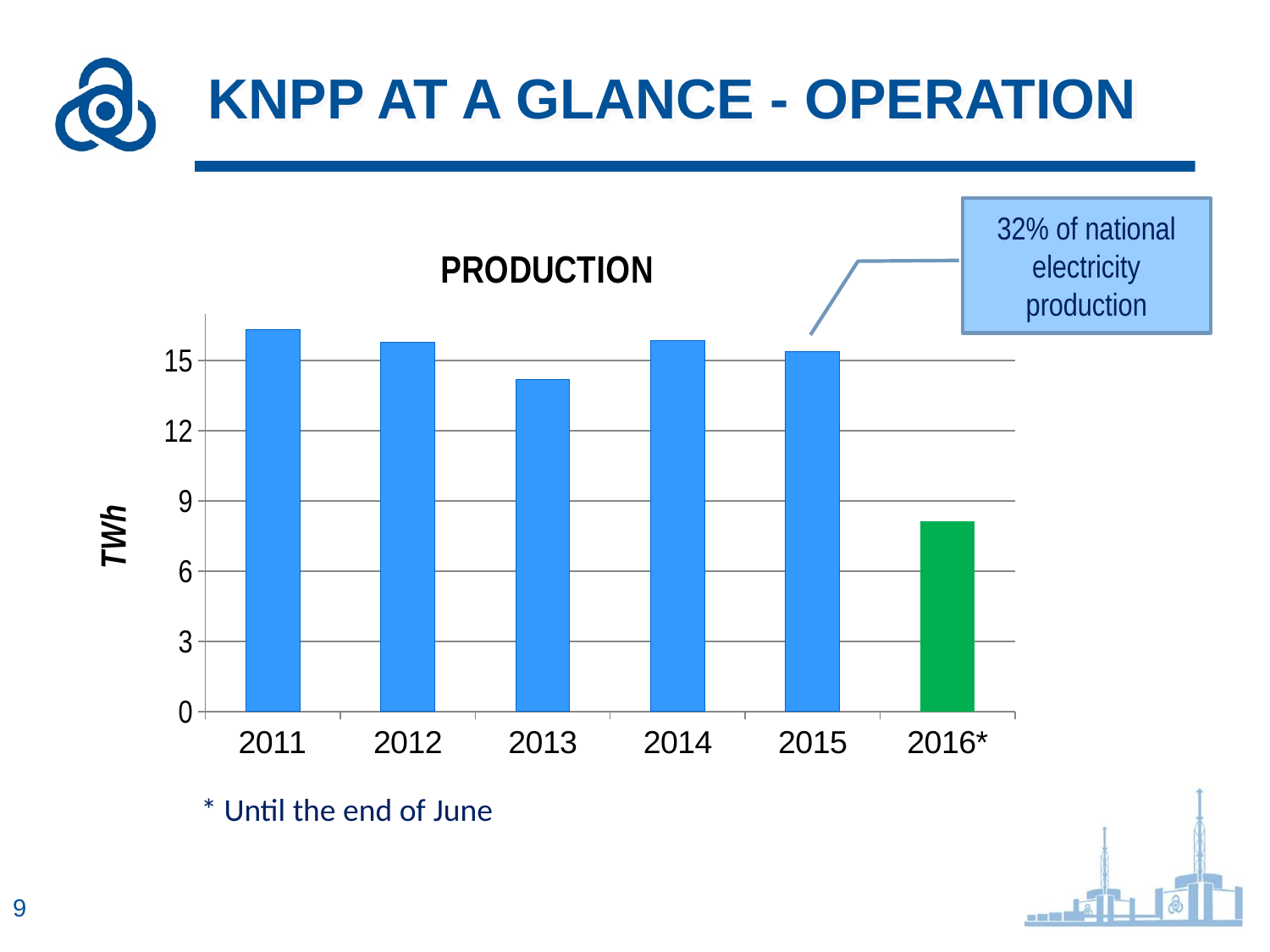
Is the production value for 2016* greater or less than 9? less Is the production value for 2012 greater or less than 15? greater Which year has the larger production, 2013 or 2014? 2014 Which year has the highest production in the chart? 2011 How many years (categories) are shown on the x axis of the chart? 6 Is the production value for 2011 greater or less than 15? greater What kind of chart is shown on the slide? bar chart Which year has the lowest production in the chart? 2016* Which year has the larger production, 2012 or 2013? 2012 What unit is shown on the y-axis label of the chart? TWh What is the title of the chart? PRODUCTION